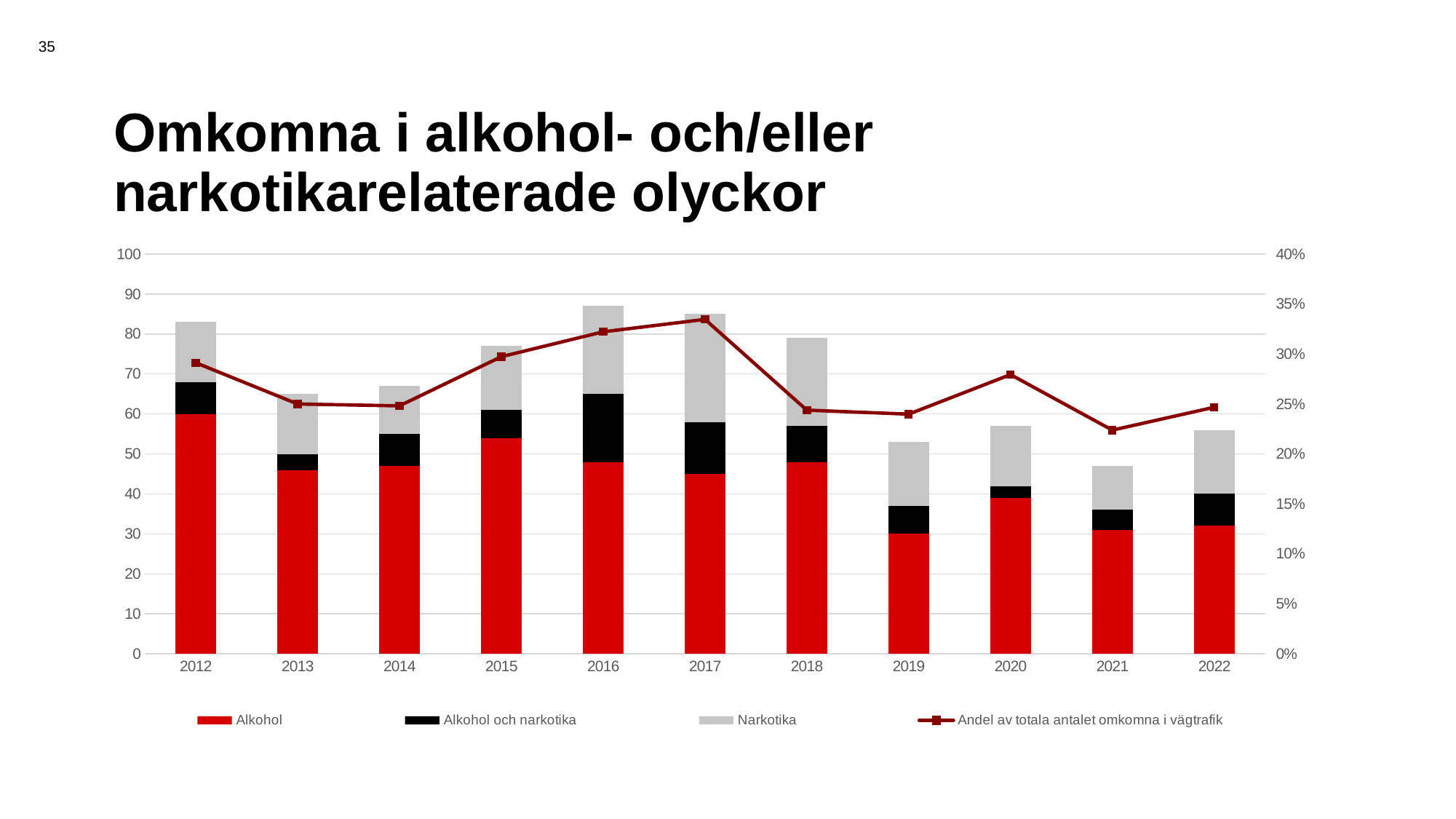
Is the total stacked bar for 2012 greater or less than 80? greater Does the 'Andel av totala antalet omkomna i vägtrafik' line rise or fall from 2014 to 2017? rise Which year has the highest Alkohol (red) value? 2012 Is the total stacked bar for 2021 greater or less than 50? less Which series is shown in red in the chart? Alkohol How many series does the chart's legend list? 4 Which year has the lowest total stacked bar? 2021 Which year has a larger total stacked bar, 2012 or 2013? 2012 What kind of chart is shown on the slide? A combined stacked bar and line chart Is the Alkohol value for 2019 greater or less than 40? less How many years are shown on the x axis of the chart? 11